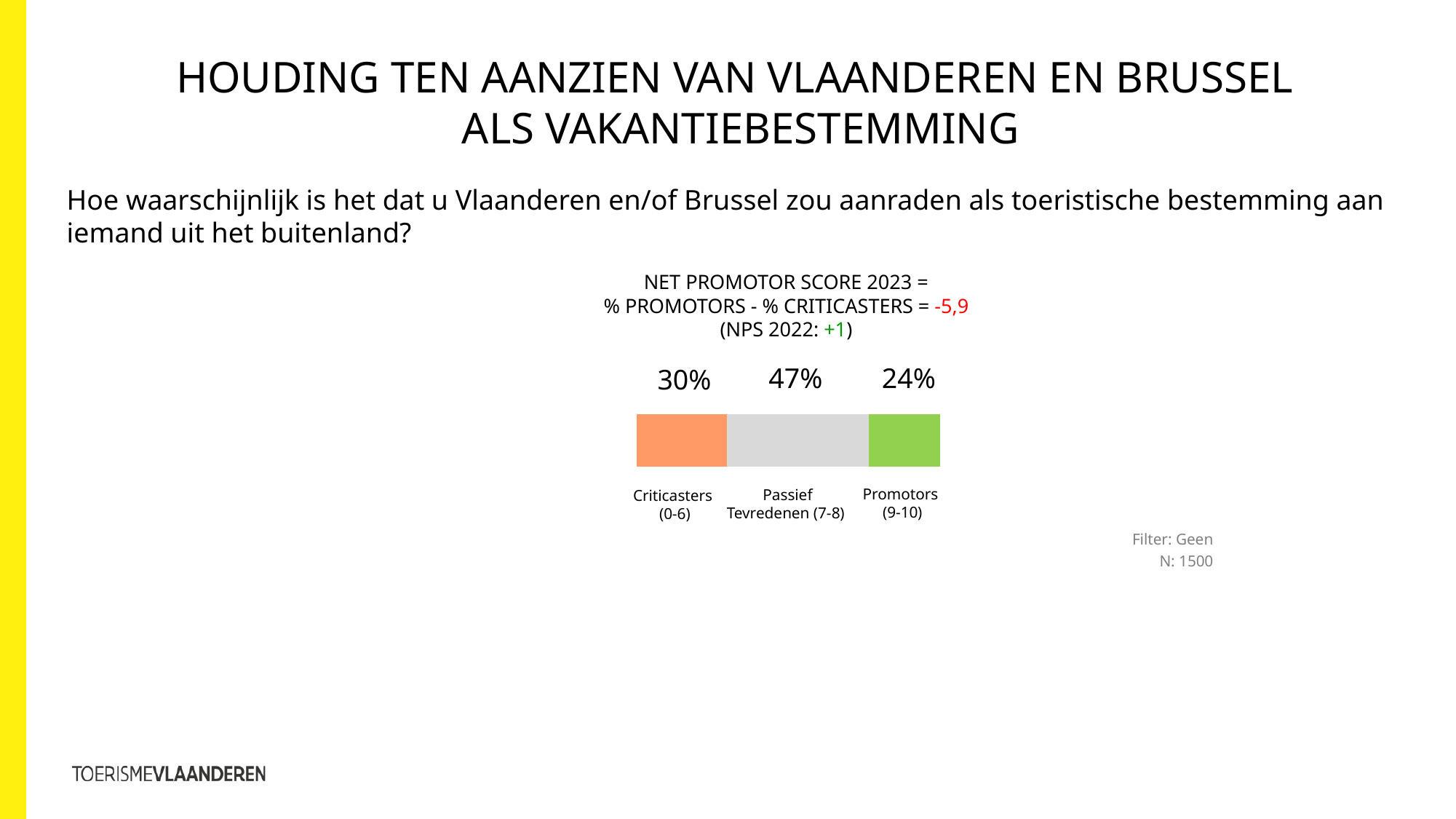
Which group has the smallest share of respondents? Promotors (9-10) What colour is the Promotors segment of the bar? Green What is the difference in percentage points between Criticasters and Promotors? 6 What kind of chart is shown on the slide? Stacked bar chart Which group has the largest share of respondents? Passief Tevredenen (7-8) Which is larger, the share of Criticasters or the share of Promotors? Criticasters What percentage of respondents are Criticasters (0-6)? 30% What percentage of respondents are Passief Tevredenen (7-8)? 47% How many segments does the bar have? 3 What is the Net Promotor Score for 2023 shown above the chart? -5,9 What is the difference in percentage points between Passief Tevredenen and Criticasters? 17 What percentage of respondents are Promotors (9-10)? 24%